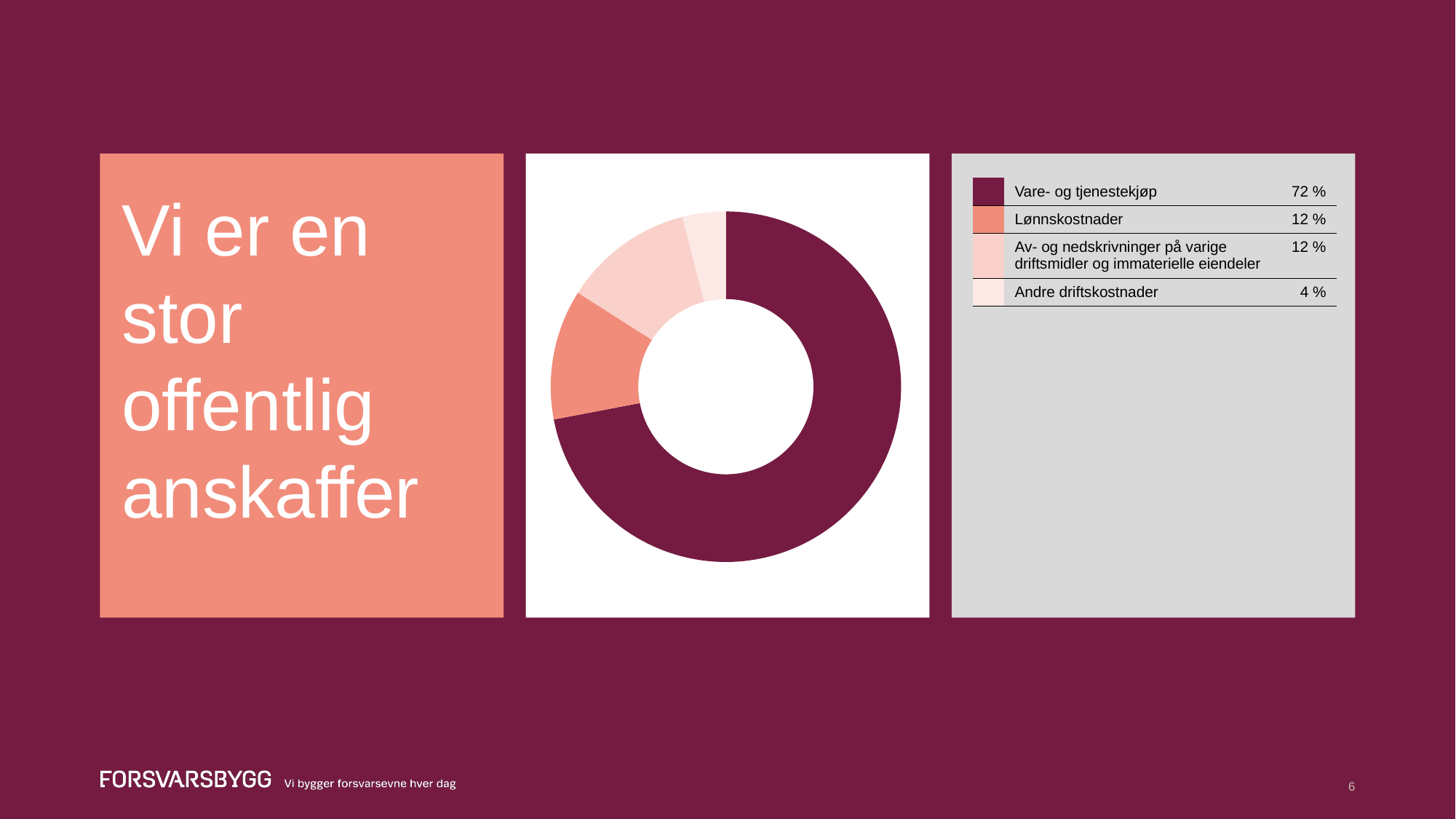
Which category has the smallest share of the donut chart? Andre driftskostnader What percentage is shown for Av- og nedskrivninger på varige driftsmidler og immaterielle eiendeler? 12 % What kind of chart is shown on the slide? Pie (donut) chart How many categories does the donut chart show? 4 What colour is the slice for Vare- og tjenestekjøp? Dark burgundy What percentage is shown for Lønnskostnader? 12 % What percentage is shown for Andre driftskostnader? 4 % How many percentage points larger is Vare- og tjenestekjøp than Lønnskostnader? 60 percentage points How many percentage points larger is Vare- og tjenestekjøp than Andre driftskostnader? 68 percentage points Which category has the largest share of the donut chart? Vare- og tjenestekjøp What share does Vare- og tjenestekjøp have in the donut chart? 72 % Which is larger, Lønnskostnader or Andre driftskostnader? Lønnskostnader